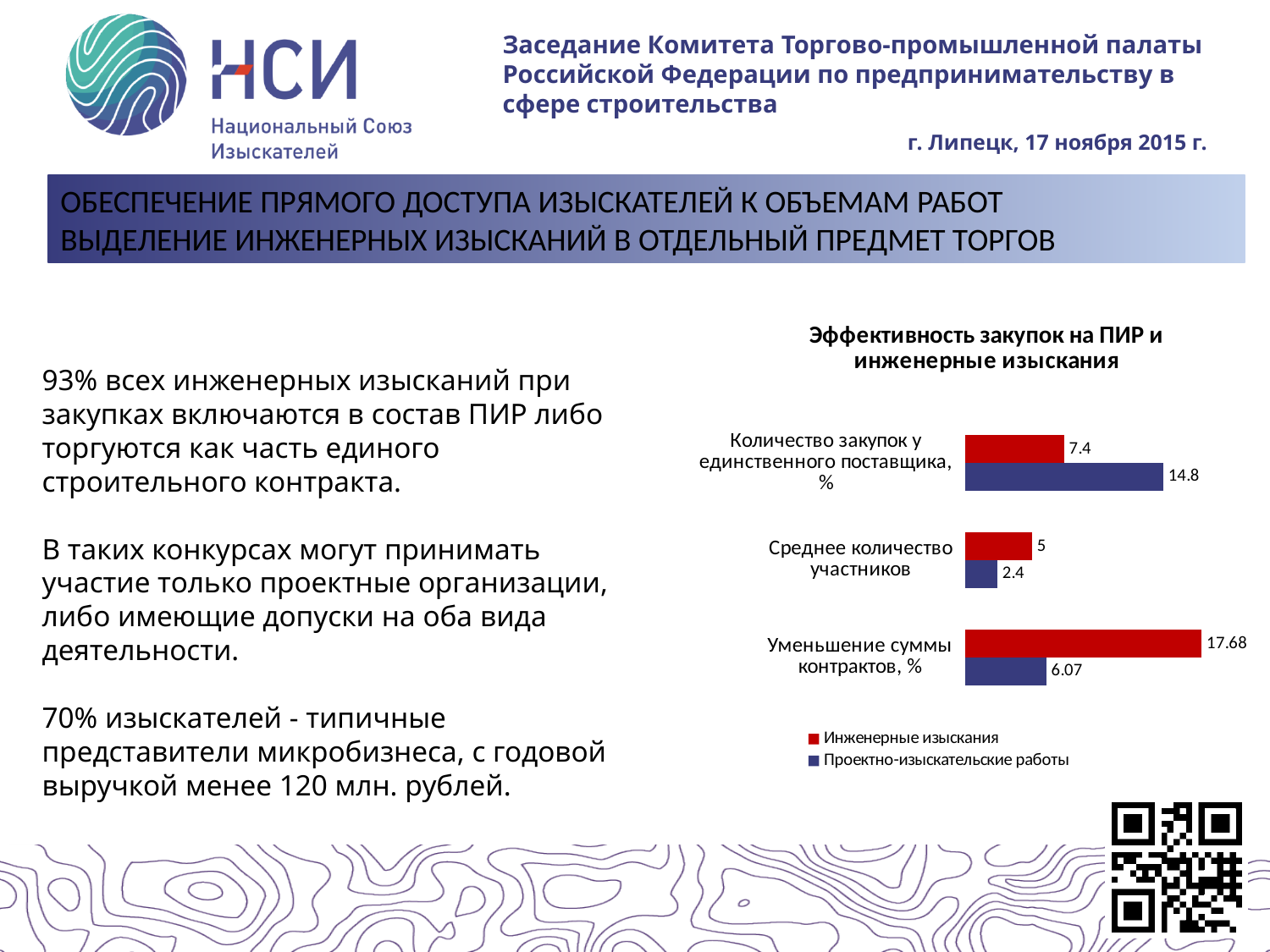
What is the value of Проектно-изыскательские работы for Количество закупок у единственного поставщика, %? 14.8 What is the value of Инженерные изыскания for Количество закупок у единственного поставщика, %? 7.4 What is the value of Проектно-изыскательские работы for Уменьшение суммы контрактов, %? 6.07 How many series does the legend list? 2 For Среднее количество участников, which series has the larger value: Инженерные изыскания or Проектно-изыскательские работы? Инженерные изыскания What is the title of the chart? Эффективность закупок на ПИР и инженерные изыскания Which category has the lowest value for Проектно-изыскательские работы? Среднее количество участников How many categories are shown on the chart? 3 Which category has the highest value for Инженерные изыскания? Уменьшение суммы контрактов, % What is the value of Инженерные изыскания for Среднее количество участников? 5 What type of chart is shown on the slide? Bar chart What is the difference between Инженерные изыскания and Проектно-изыскательские работы for Уменьшение суммы контрактов, %? 11.61